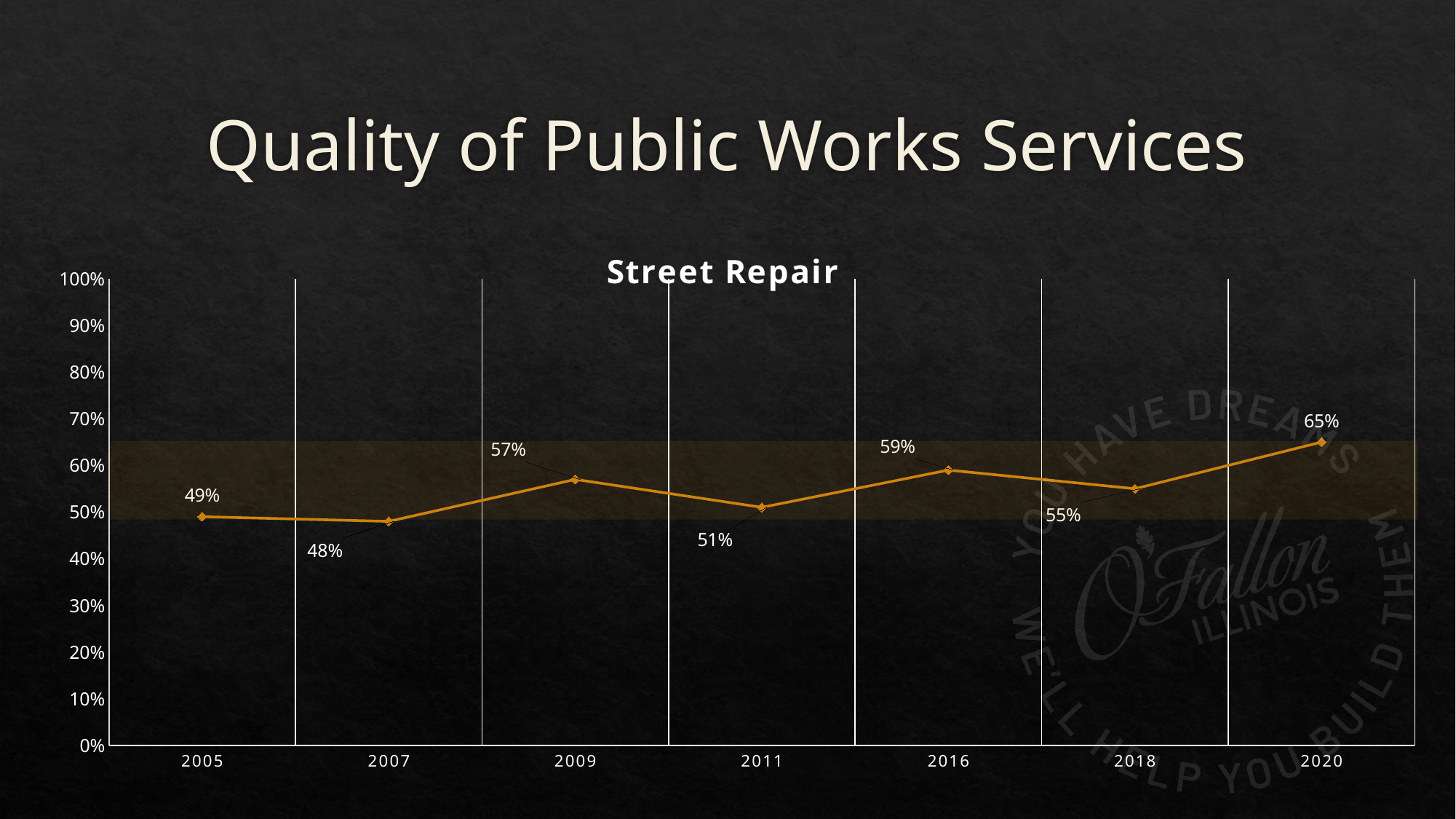
Which is larger, the Street Repair value for 2009 or for 2011? 2009 What kind of chart is shown on the slide? Line chart What is the Street Repair value for 2011? 51% Is the Street Repair value for 2016 greater or less than 50%? greater How many years are plotted on the Street Repair chart? 7 Which year has the lowest Street Repair value? 2007 What is the Street Repair value for 2020? 65% Does the Street Repair value rise or fall between 2016 and 2018? Fall What is the title of the chart? Street Repair What is the difference between the Street Repair values for 2020 and 2005? 16% Which year has the highest Street Repair value? 2020 What is the Street Repair value for 2005? 49%